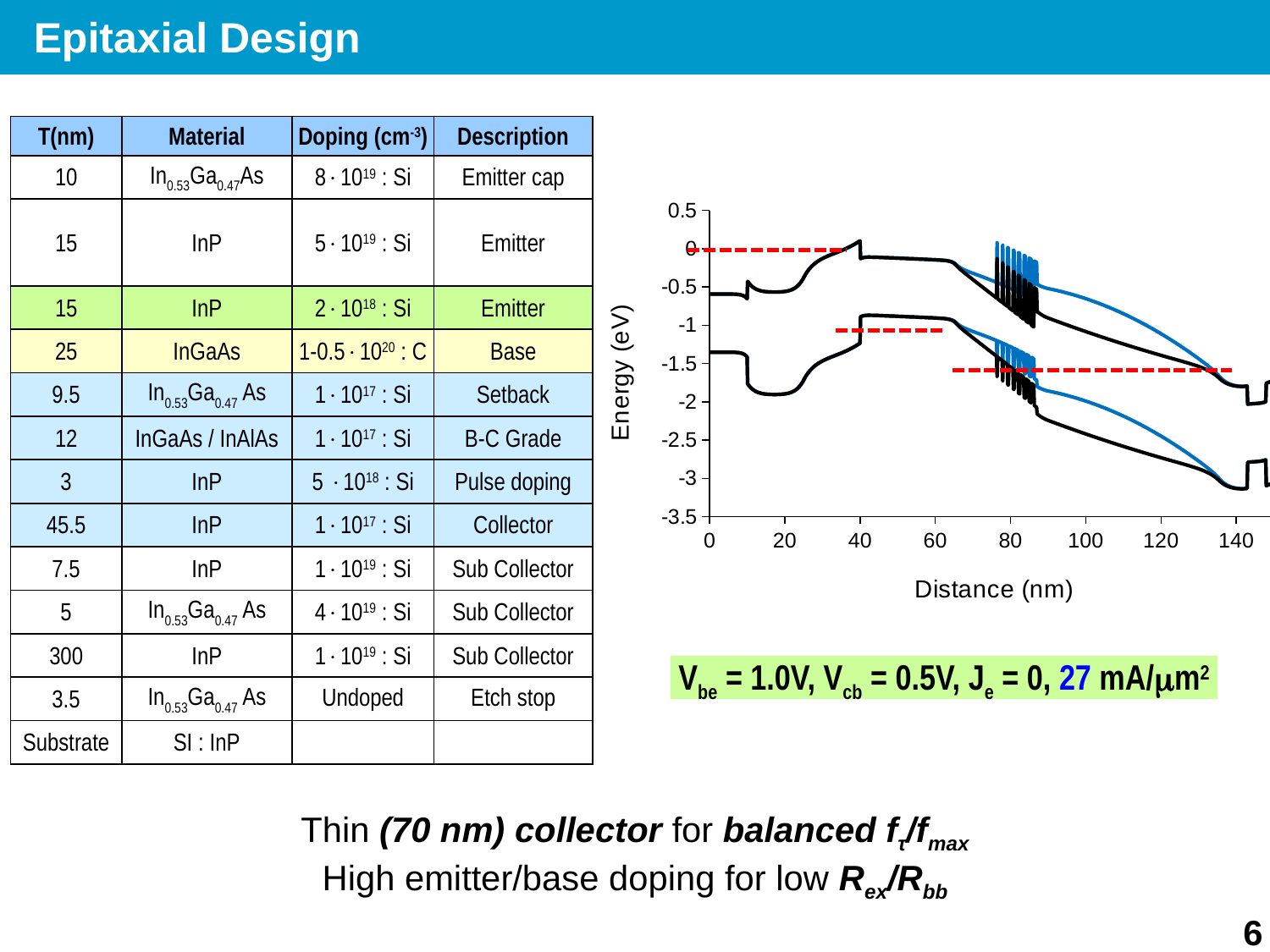
What kind of chart is shown on the right of the slide? line chart How many labelled tick marks are there on the x axis of the chart? 8 Is the energy of the upper black curve at a distance of 140 nm greater or less than -1 eV? less What is the lowest tick value shown on the y axis of the chart? -3.5 What is the highest tick value shown on the y axis of the chart? 0.5 What is the label of the y axis of the chart? Energy (eV) Overall, do the energy curves rise or fall as distance increases from 40 nm to 140 nm? fall Is the energy of the upper black curve at a distance of 0 nm greater or less than 0 eV? less What is the largest tick value labelled on the x axis of the chart? 140 What is the label of the x axis of the chart? Distance (nm) Is the energy of the lower black curve at a distance of 0 nm greater or less than -2 eV? greater